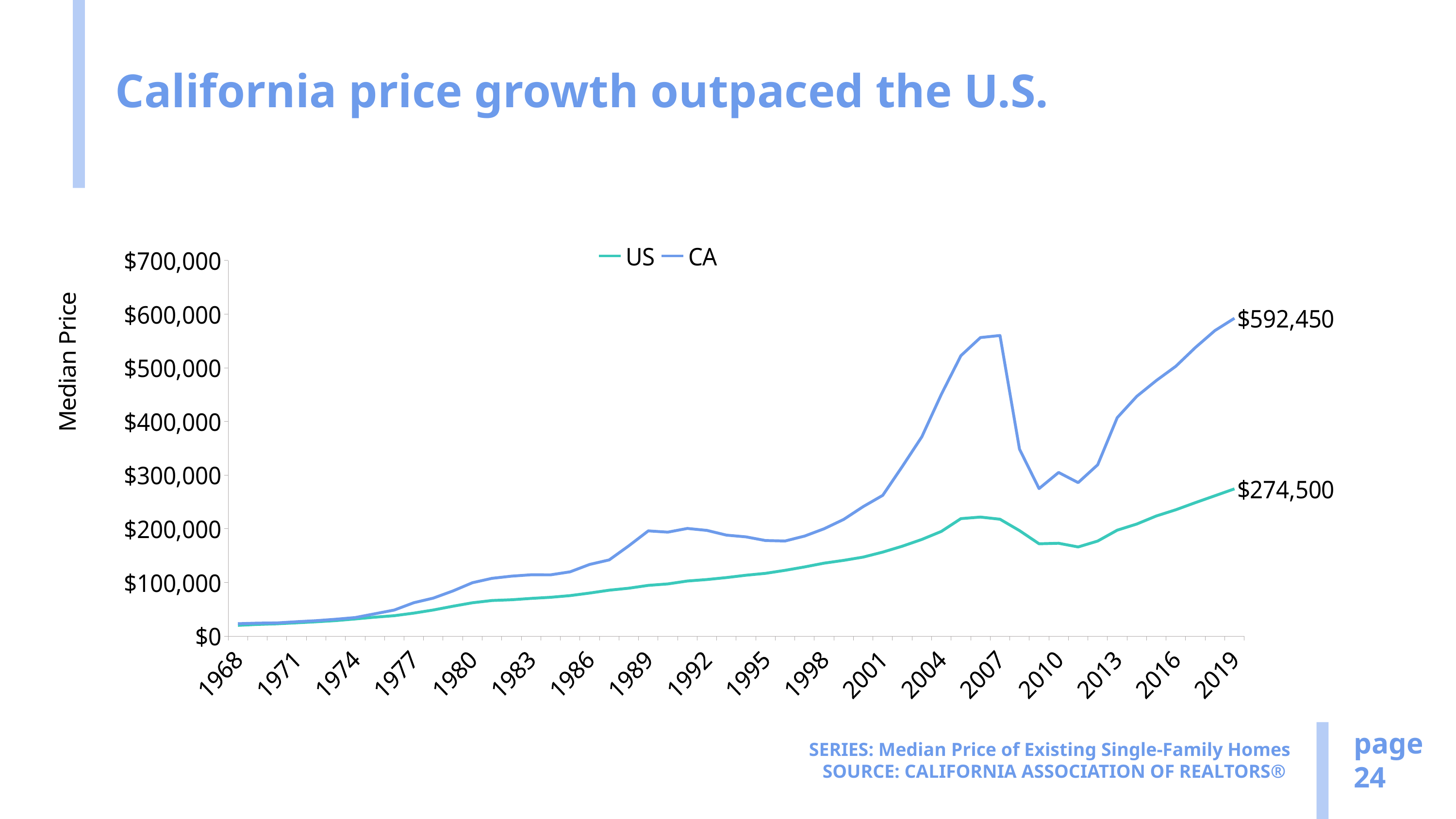
Is the value for US in 2007 greater or less than $300,000? less How many series does the legend list? 2 What is the label on the vertical axis of the chart? Median Price What is the median price for US in 2019? $274,500 Which series has the higher median price in 2019, US or CA? CA Does the US median price overall rise or fall from 1968 to 2019? rise Is the value for CA in 2007 greater or less than $500,000? greater Is the value for CA in 1989 greater or less than $100,000? greater What kind of chart is shown on the slide? Line chart What is the difference between the CA and US median prices in 2019? $317,950 What is the median price for CA in 2019? $592,450